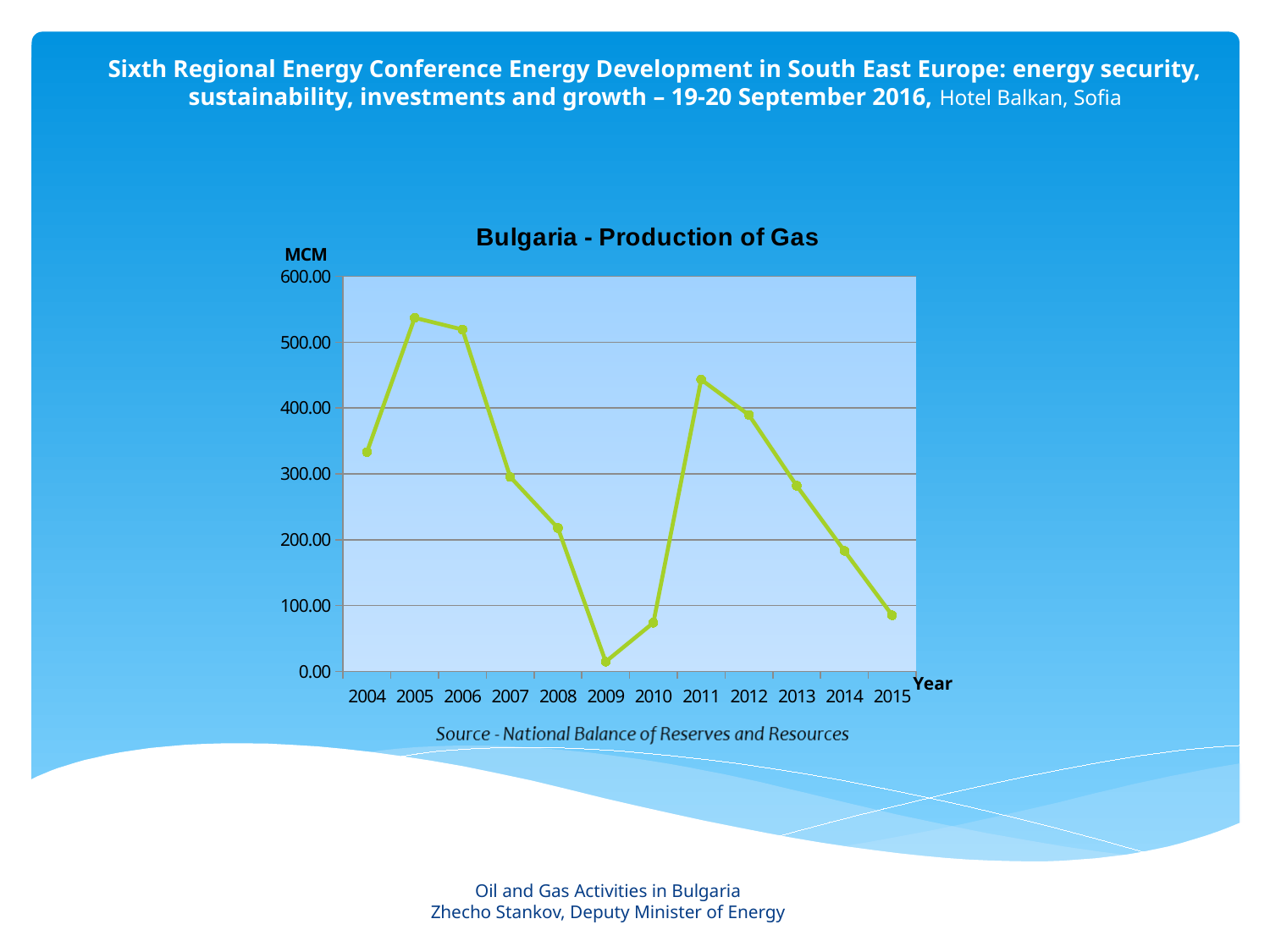
What kind of chart is shown on the slide? line chart Do the values rise or fall from 2011 to 2015? fall What unit is shown on the vertical axis of the chart? MCM Is the value for 2011 greater or less than 400.00? greater In which year was gas production highest? 2005 Which year has the higher gas production, 2004 or 2011? 2011 Is the value for 2005 greater or less than 500.00? greater Is the value for 2004 greater or less than 300.00? greater What is the title of the chart? Bulgaria - Production of Gas In which year was gas production lowest? 2009 How many years are plotted on the x axis of the chart? 12